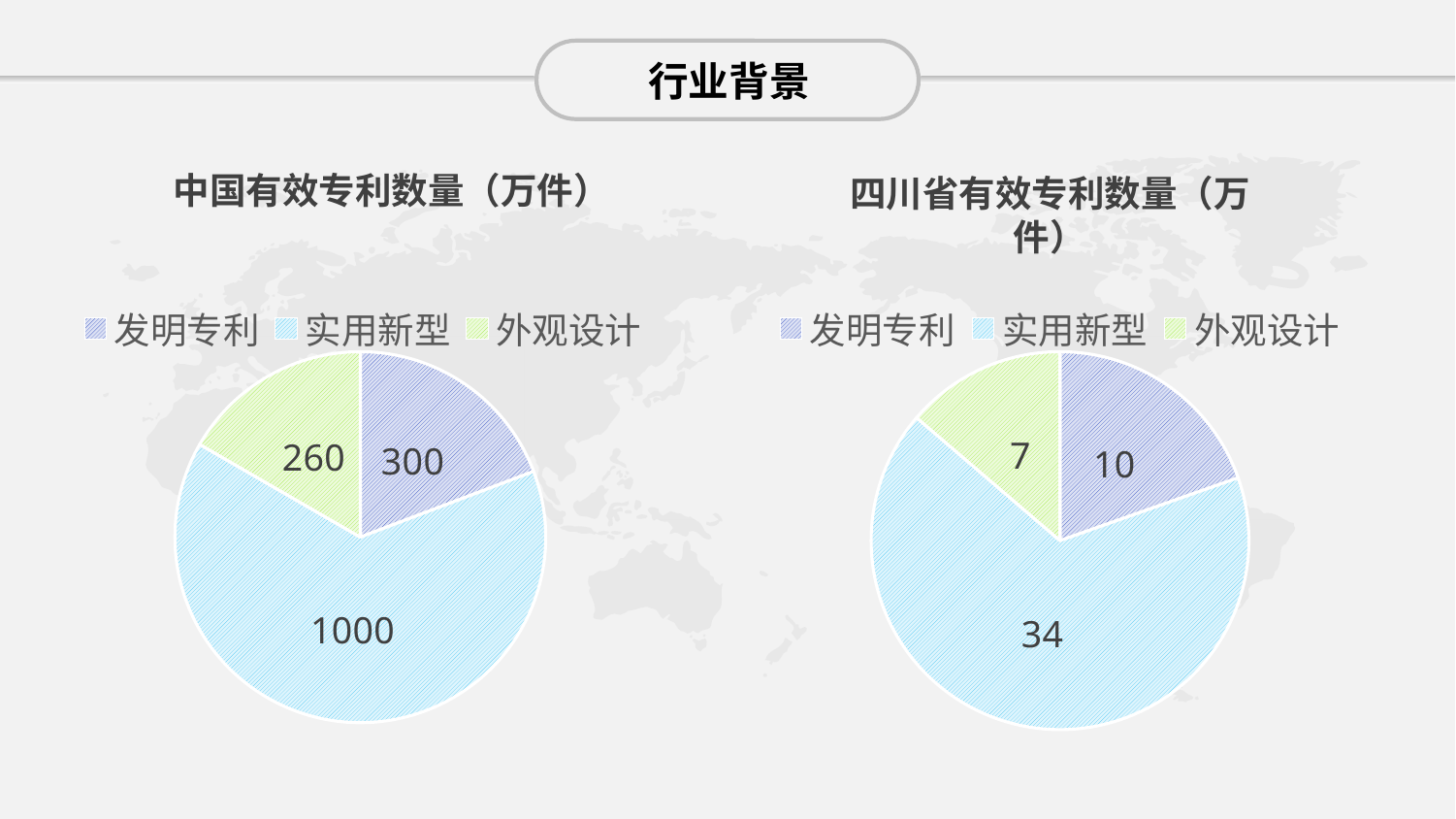
In the chart titled 四川省有效专利数量（万件）, which category has the smallest slice? 外观设计 In the chart titled 中国有效专利数量（万件）, what is the value for 外观设计? 260 In the chart titled 中国有效专利数量（万件）, what is the difference between the values for 发明专利 and 外观设计? 40 In the chart titled 四川省有效专利数量（万件）, what is the value for 发明专利? 10 In the chart titled 中国有效专利数量（万件）, which category has the largest slice? 实用新型 In the chart titled 中国有效专利数量（万件）, what share of the total does 实用新型 represent? 64.1% In the chart titled 四川省有效专利数量（万件）, which is larger, 发明专利 or 外观设计? 发明专利 In the chart titled 中国有效专利数量（万件）, what is the value for 实用新型? 1000 In the chart titled 四川省有效专利数量（万件）, what is the difference between the values for 实用新型 and 发明专利? 24 In the chart titled 四川省有效专利数量（万件）, what is the value for 实用新型? 34 How many categories does the chart titled 中国有效专利数量（万件）show? 3 What kind of chart is the chart titled 四川省有效专利数量（万件）? Pie chart